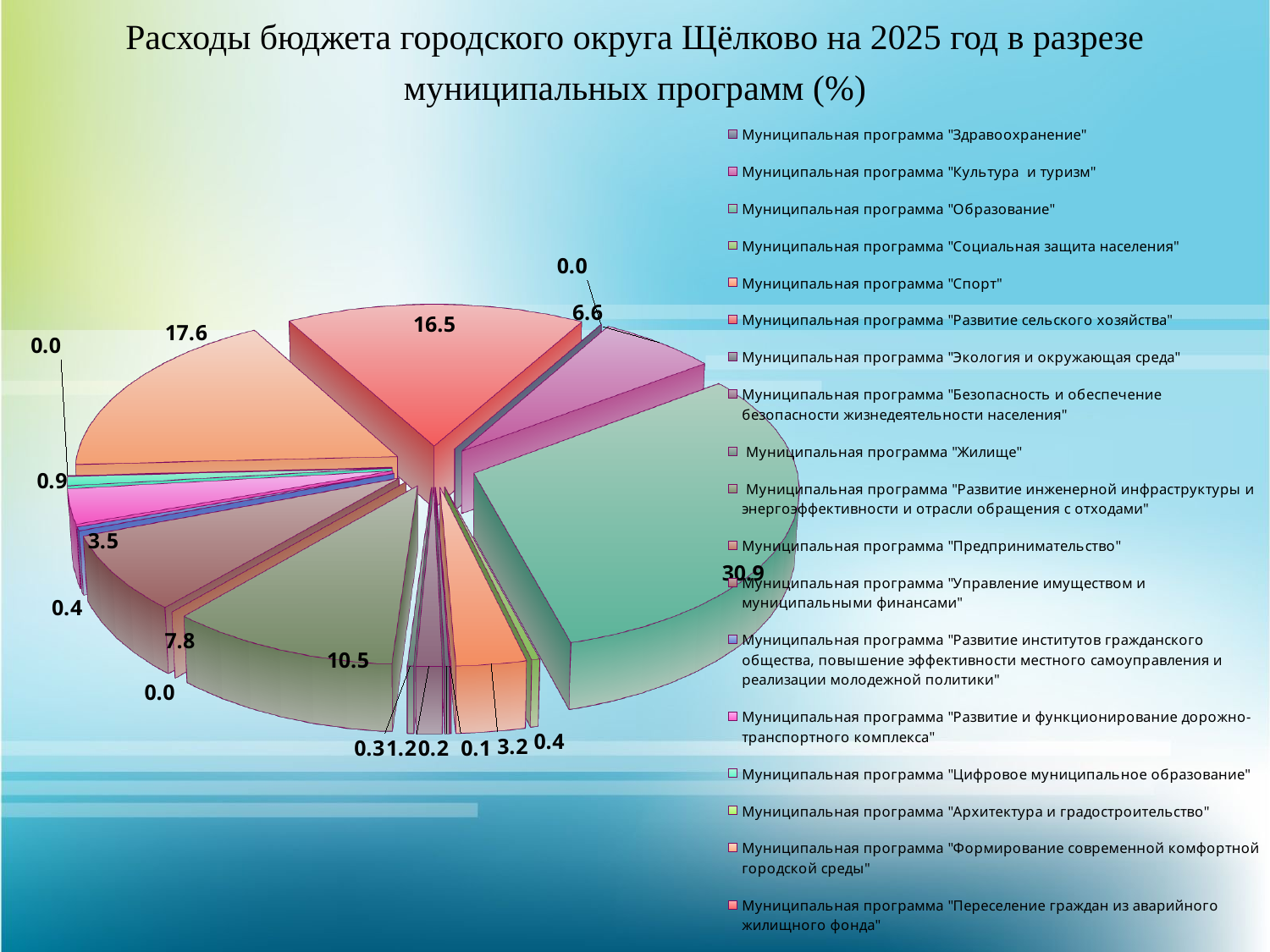
How many data labels are shown on the pie chart? 18 What is the value of the third-largest slice in the pie chart? 16.5 How many slices in the pie chart are labelled 0.0? 3 What share of the budget does the largest slice represent, according to its data label? 30.9 What is the difference between the slices labelled 17.6 and 16.5? 1.1 What is the title of the chart? Расходы бюджета городского округа Щёлково на 2025 год в разрезе муниципальных программ (%) What is the value of the largest slice in the pie chart? 30.9 What kind of chart is shown on the slide? pie chart Which is larger, the slice labelled 10.5 or the slice labelled 7.8? 10.5 What is the difference between the largest slice (30.9) and the second-largest slice (17.6)? 13.3 What is the value of the second-largest slice in the pie chart? 17.6 How many municipal programmes are listed in the chart's legend? 18